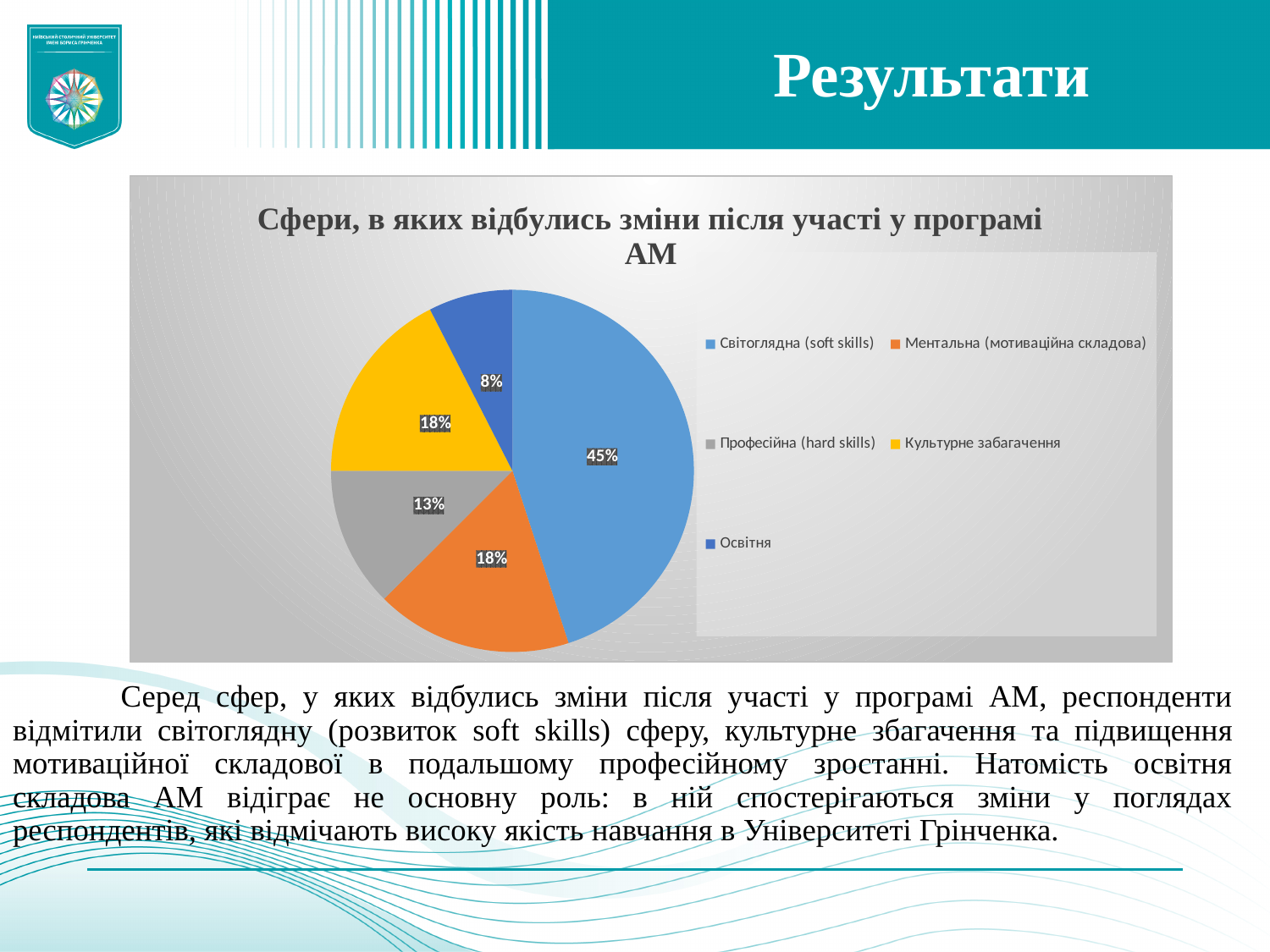
What share of the pie is Ментальна (мотиваційна складова)? 18% What share of the pie is Професійна (hard skills)? 13% Which category has the largest share of the pie? Світоглядна (soft skills) How many slices does the pie chart have? 5 What share of the pie is Світоглядна (soft skills)? 45% Which category has the smallest share of the pie? Освітня What is the title of the chart? Сфери, в яких відбулись зміни після участі у програмі АМ Which is larger, the share of Професійна (hard skills) or the share of Освітня? Професійна (hard skills) What is the difference between the shares of Світоглядна (soft skills) and Професійна (hard skills)? 32% What kind of chart is shown on the slide? pie chart